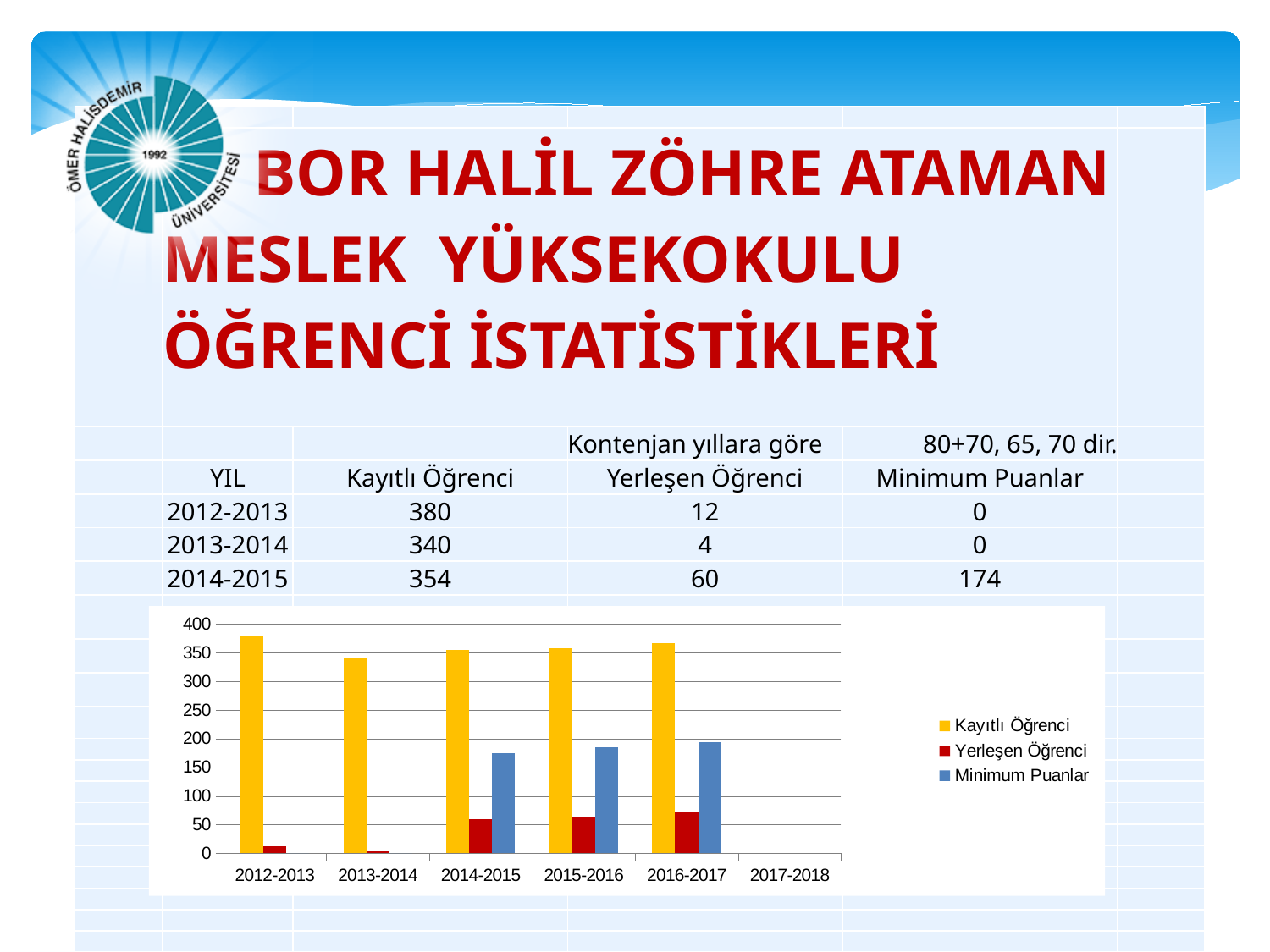
What is the difference between the Kayıtlı Öğrenci values for 2012-2013 and 2013-2014? 40 What is the Yerleşen Öğrenci value for 2013-2014? 4 How many series does the chart legend list? 3 How many categories are shown on the x axis of the chart? 6 Is the Yerleşen Öğrenci value for 2016-2017 greater or less than 100? less Which year has the highest Kayıtlı Öğrenci bar? 2012-2013 What is the Minimum Puanlar value for 2014-2015? 174 What is the Kayıtlı Öğrenci value for 2012-2013? 380 What kind of chart is shown on the slide? bar chart Which colour represents Kayıtlı Öğrenci in the chart legend? yellow Which year has the lowest Yerleşen Öğrenci bar? 2013-2014 Is the Minimum Puanlar value for 2015-2016 greater or less than 150? greater